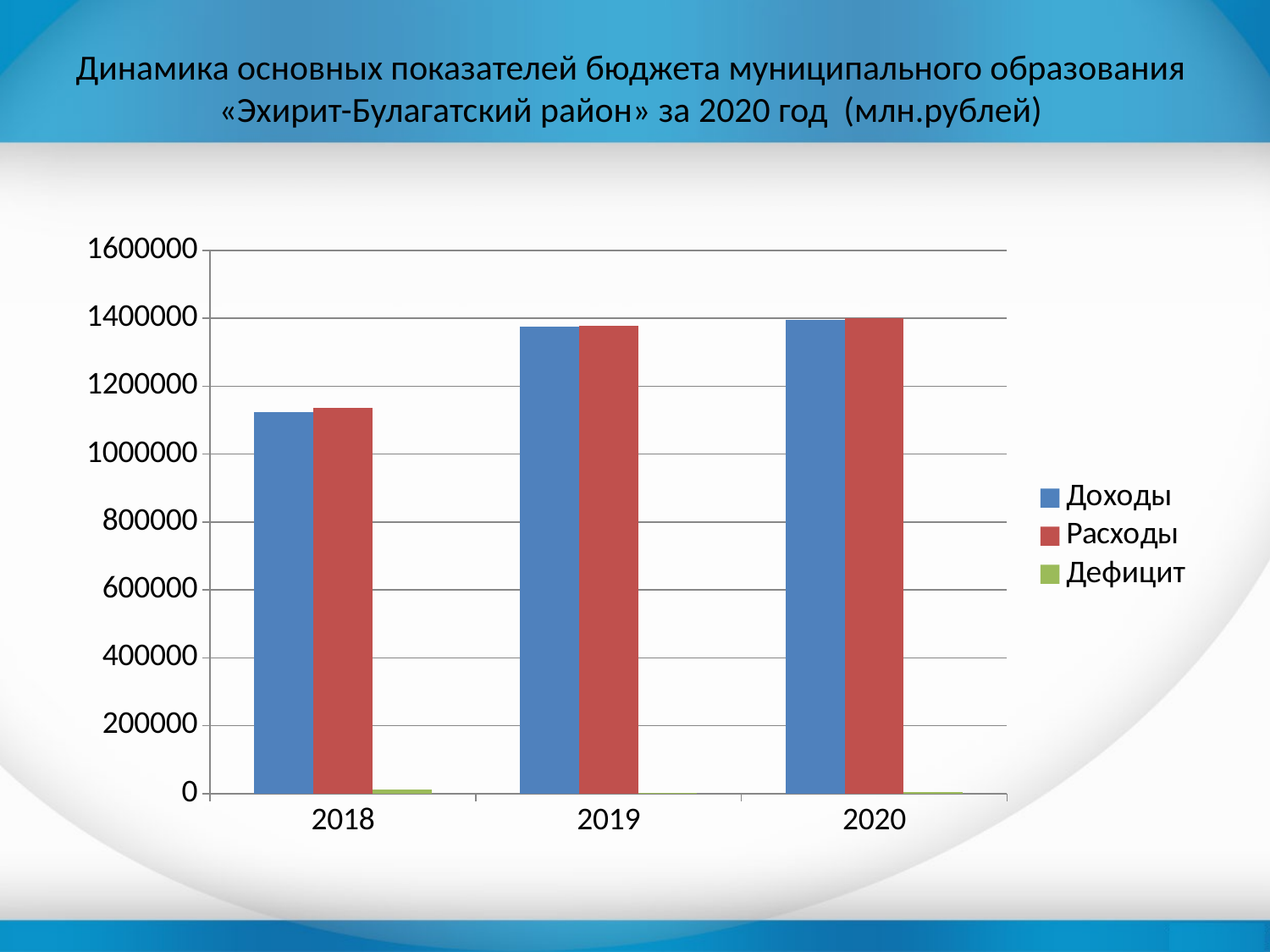
Which year has the lowest value for Доходы? 2018 Which series are listed in the legend? Доходы, Расходы, Дефицит How many years are shown on the x axis? 3 Is the value for Доходы in 2018 greater or less than 1200000? less Is the value for Доходы in 2018 greater or less than 1000000? greater How many series does the legend list? 3 Which is larger: Доходы in 2018 or Доходы in 2019? Доходы in 2019 Is the value for Расходы in 2019 greater or less than 1200000? greater What kind of chart is shown on the slide? bar chart Do the values for Доходы rise or fall from 2018 to 2020? rise Which year has the lowest value for Расходы? 2018